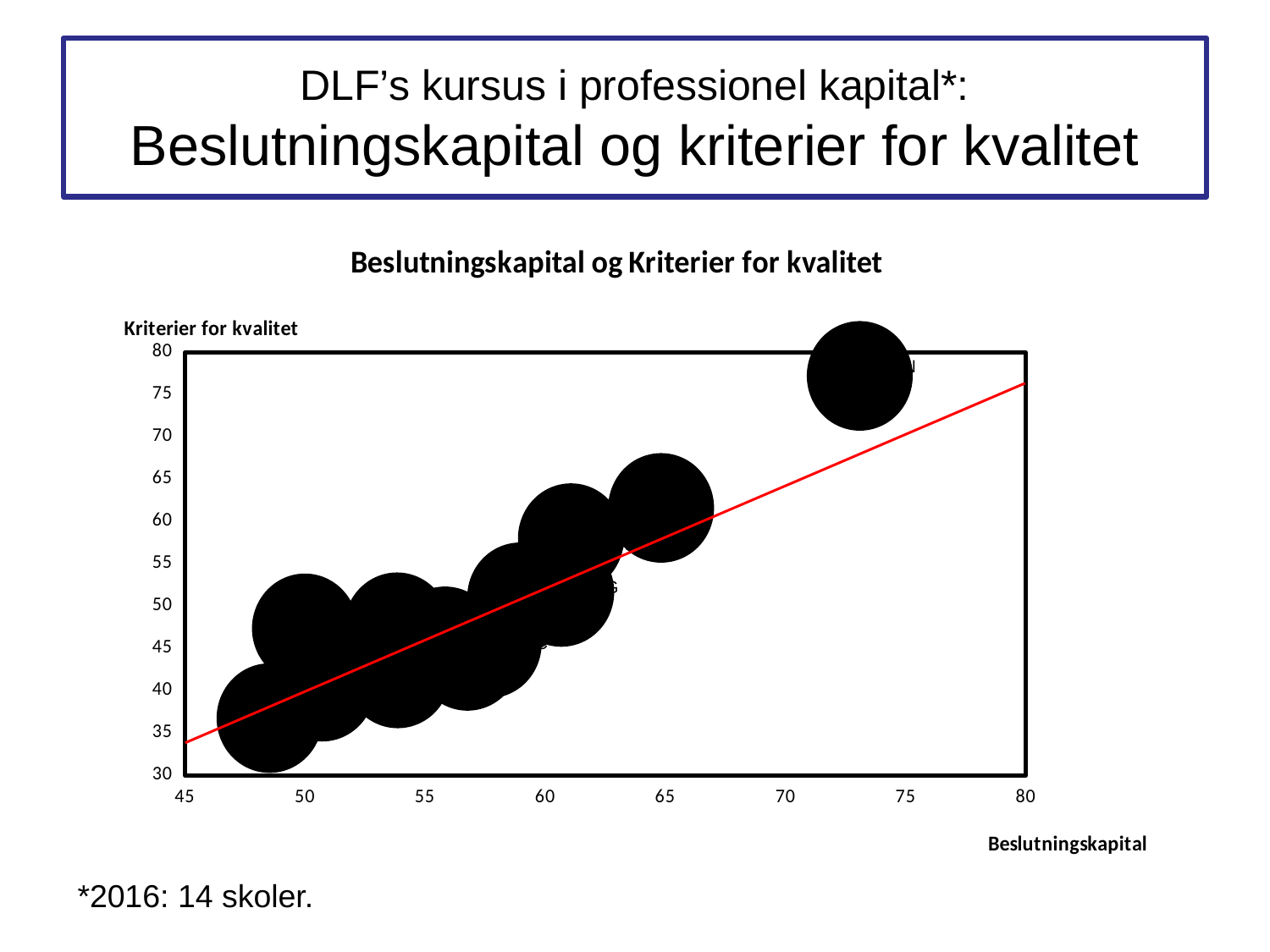
Is the Kriterier for kvalitet value of the highest point in the chart greater or less than 70? greater What kind of chart is shown on the slide? scatter chart What is the title of the chart? Beslutningskapital og Kriterier for kvalitet Is the Kriterier for kvalitet value of the lowest point in the chart greater or less than 40? less According to the footnote, how many schools are represented in the chart? 14 Is the Beslutningskapital value of the highest point in the chart greater or less than 70? greater What is the label of the vertical axis of the chart? Kriterier for kvalitet Does the red trend line in the chart rise or fall as Beslutningskapital increases? rise